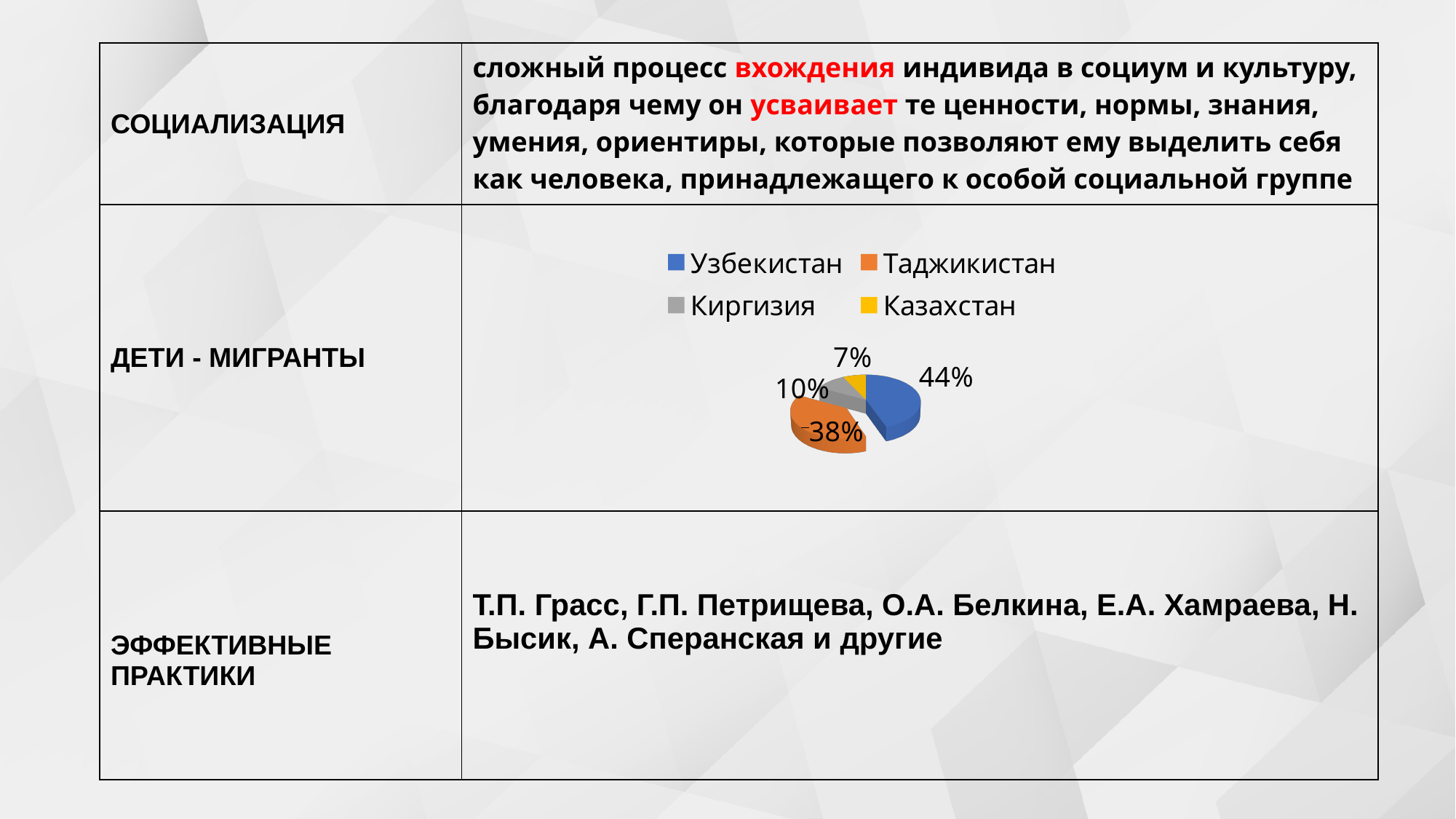
How many entries does the legend list? 4 Which is larger, the slice for Киргизия or the slice for Казахстан? Киргизия How many slices does the pie chart have? 4 What is the difference in percentage points between Узбекистан and Таджикистан? 6 Which colour represents Таджикистан in the pie chart? orange What is the value shown for Таджикистан? 38% What kind of chart is shown on the slide? pie chart What is the value shown for Киргизия? 10% Which category has the smallest slice of the pie? Казахстан Which category has the largest slice of the pie? Узбекистан What is the value shown for Казахстан? 7% What share of the pie does Узбекистан have? 44%